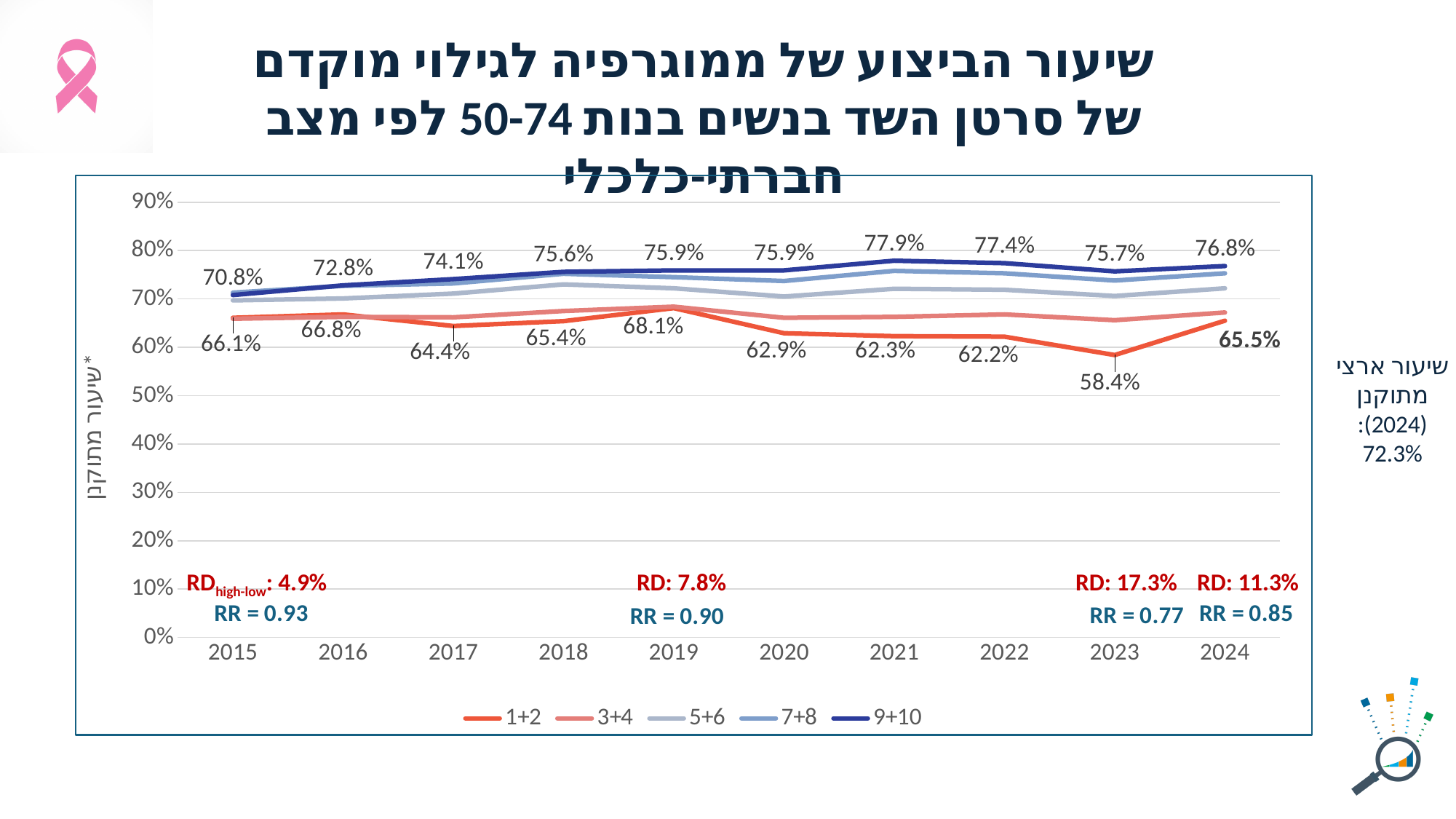
How many years are shown on the x axis? 10 What type of chart is shown on the slide? line chart In which year does the 1+2 series reach its lowest value? 2023 Does the 9+10 series rise or fall from 2015 to 2018? rise What is the difference between the 9+10 series and the 1+2 series in 2023? 17.3% Is the value for the 1+2 series in 2023 greater or less than 60%? less In which year does the 9+10 series reach its highest value? 2021 How many series does the legend list? 5 What is the value for the 9+10 series in 2021? 77.9% What is the value for the 1+2 series in 2024? 65.5% What is the value for the 1+2 series in 2023? 58.4% Which series has the larger value in 2015, 9+10 or 1+2? 9+10